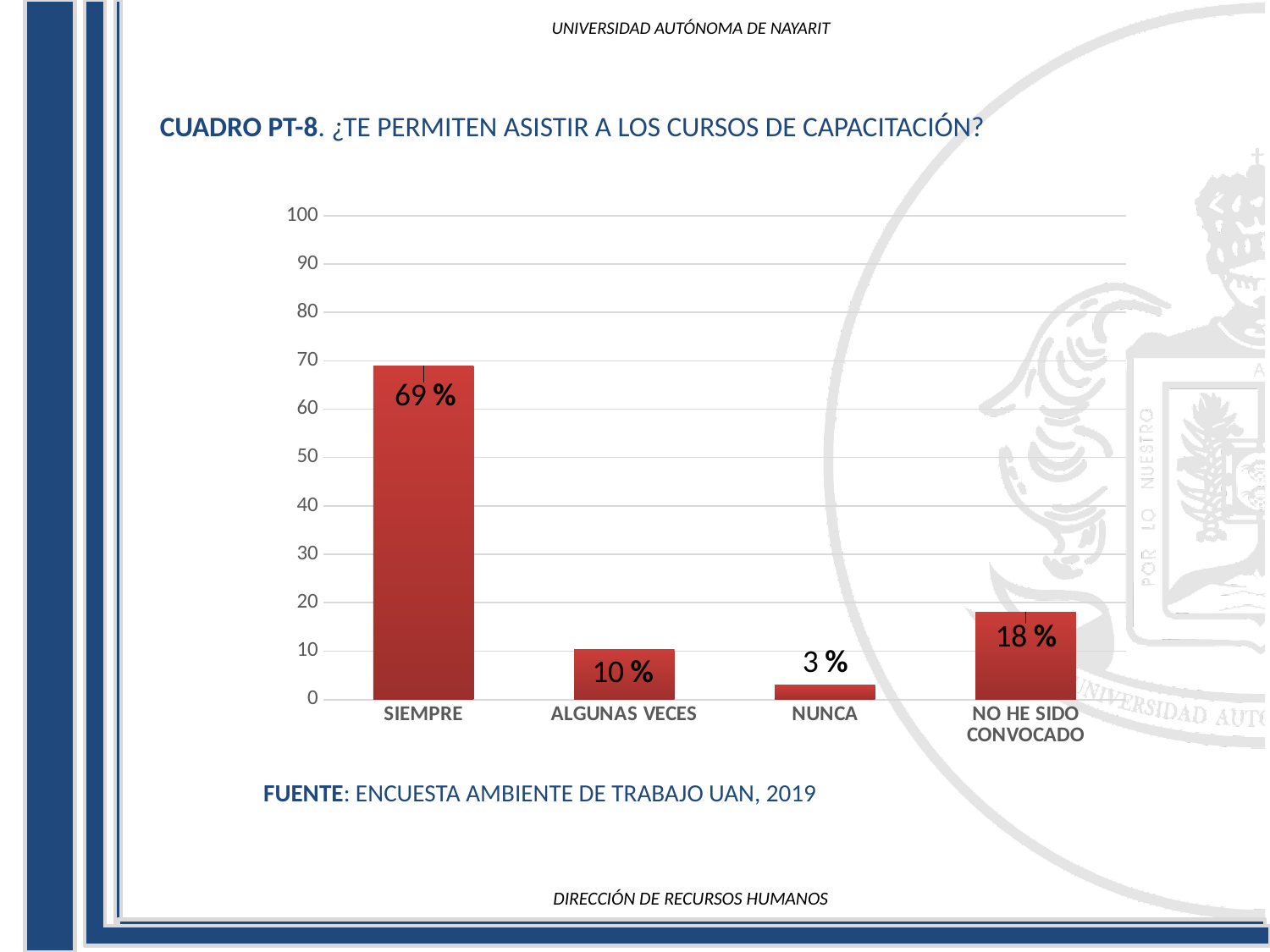
Which is larger, the value for ALGUNAS VECES or the value for NO HE SIDO CONVOCADO? NO HE SIDO CONVOCADO What kind of chart is shown on the slide? bar chart What is the difference between the values for SIEMPRE and NO HE SIDO CONVOCADO? 51 % What is the value for ALGUNAS VECES? 10 % What is the source cited below the chart? ENCUESTA AMBIENTE DE TRABAJO UAN, 2019 What is the value for NUNCA? 3 % Which category has the highest value? SIEMPRE What is the value for NO HE SIDO CONVOCADO? 18 % How many categories are shown on the x axis? 4 Which category has the lowest value? NUNCA Is the value for SIEMPRE greater or less than 60? greater What is the value for SIEMPRE? 69 %